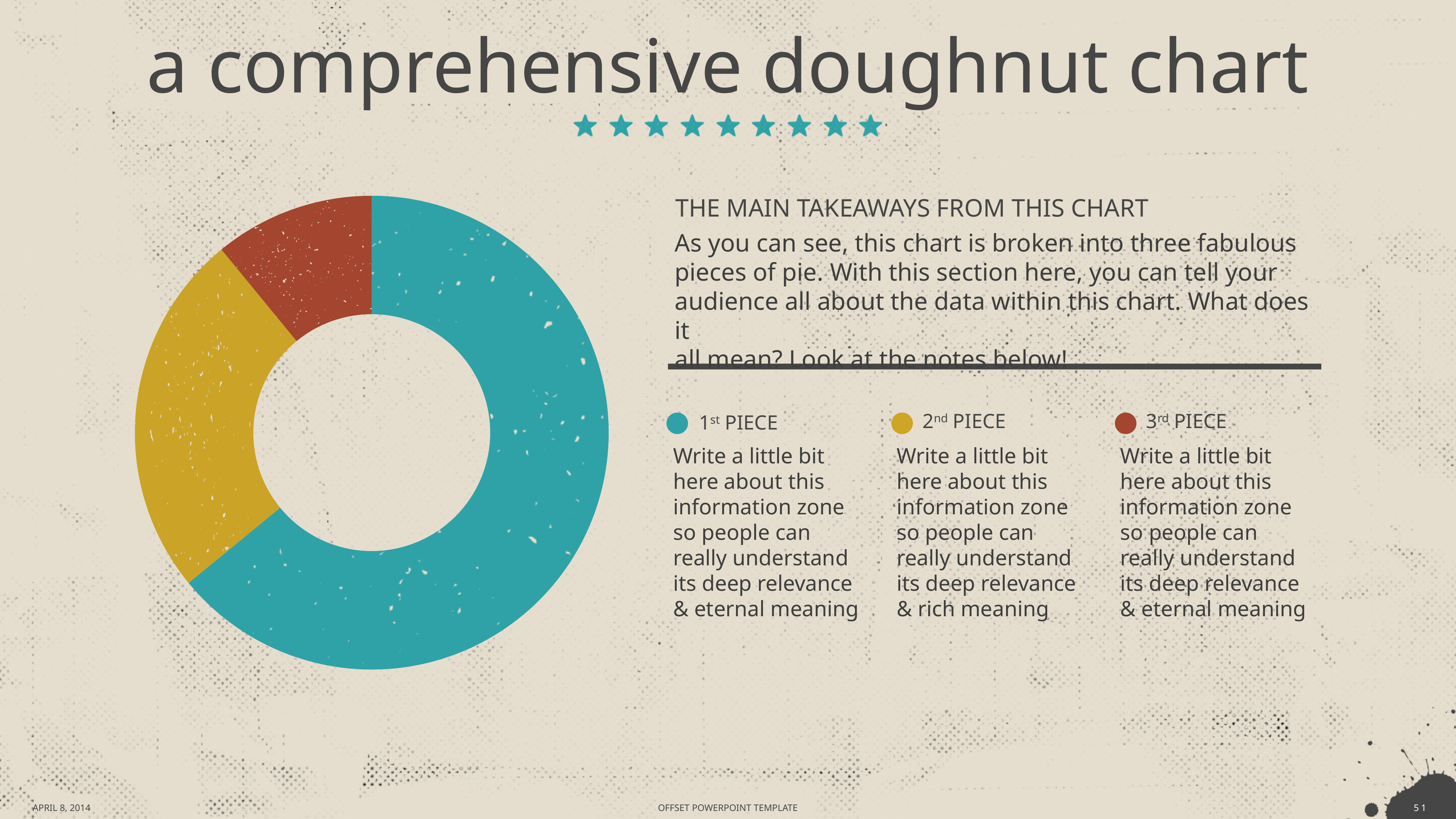
Does the 1st PIECE take up more or less than half of the doughnut chart? more Which piece of the doughnut chart is the smallest? 3rd PIECE Which piece of the doughnut chart is the largest? 1st PIECE How many pieces does the doughnut chart have? 3 Which is larger in the doughnut chart, the 2nd PIECE or the 3rd PIECE? 2nd PIECE Which is larger in the doughnut chart, the 1st PIECE or the 2nd PIECE? 1st PIECE What kind of chart is shown on the slide? doughnut chart What colour represents the 2nd PIECE in the doughnut chart? yellow What is the title of the slide containing the doughnut chart? a comprehensive doughnut chart